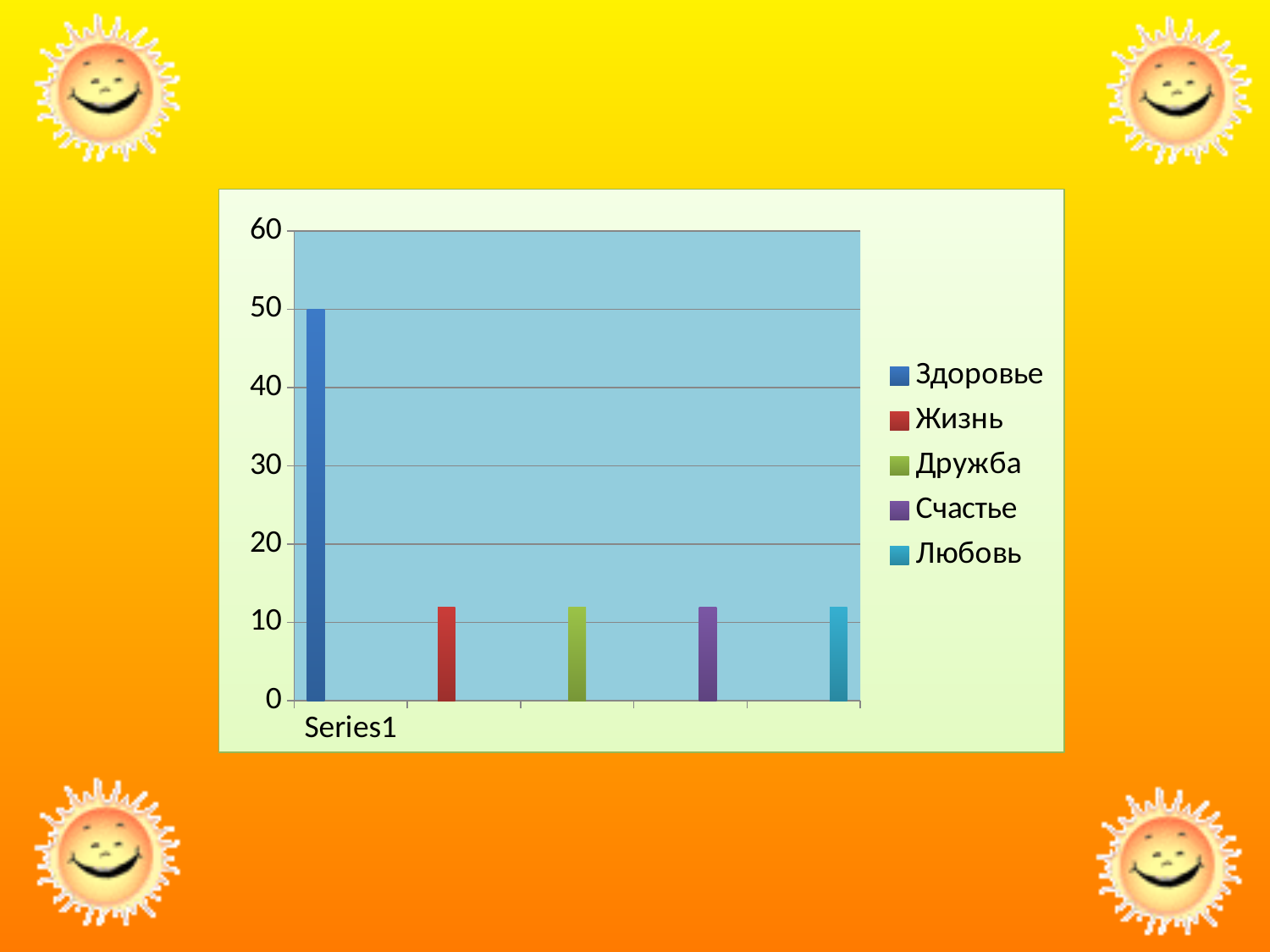
Is the value for Дружба greater or less than 10? greater What is the highest value shown on the vertical axis? 60 Is the value for Здоровье greater or less than 40? greater What is the value of the Здоровье bar? 50 What is the label shown on the x axis under the bars? Series1 What kind of chart is shown on the slide? bar chart Which series has the highest value? Здоровье How many series does the legend list? 5 Is the value for Любовь greater or less than 20? less What colour is the Здоровье bar? blue Which is larger, the value for Здоровье or the value for Жизнь? Здоровье